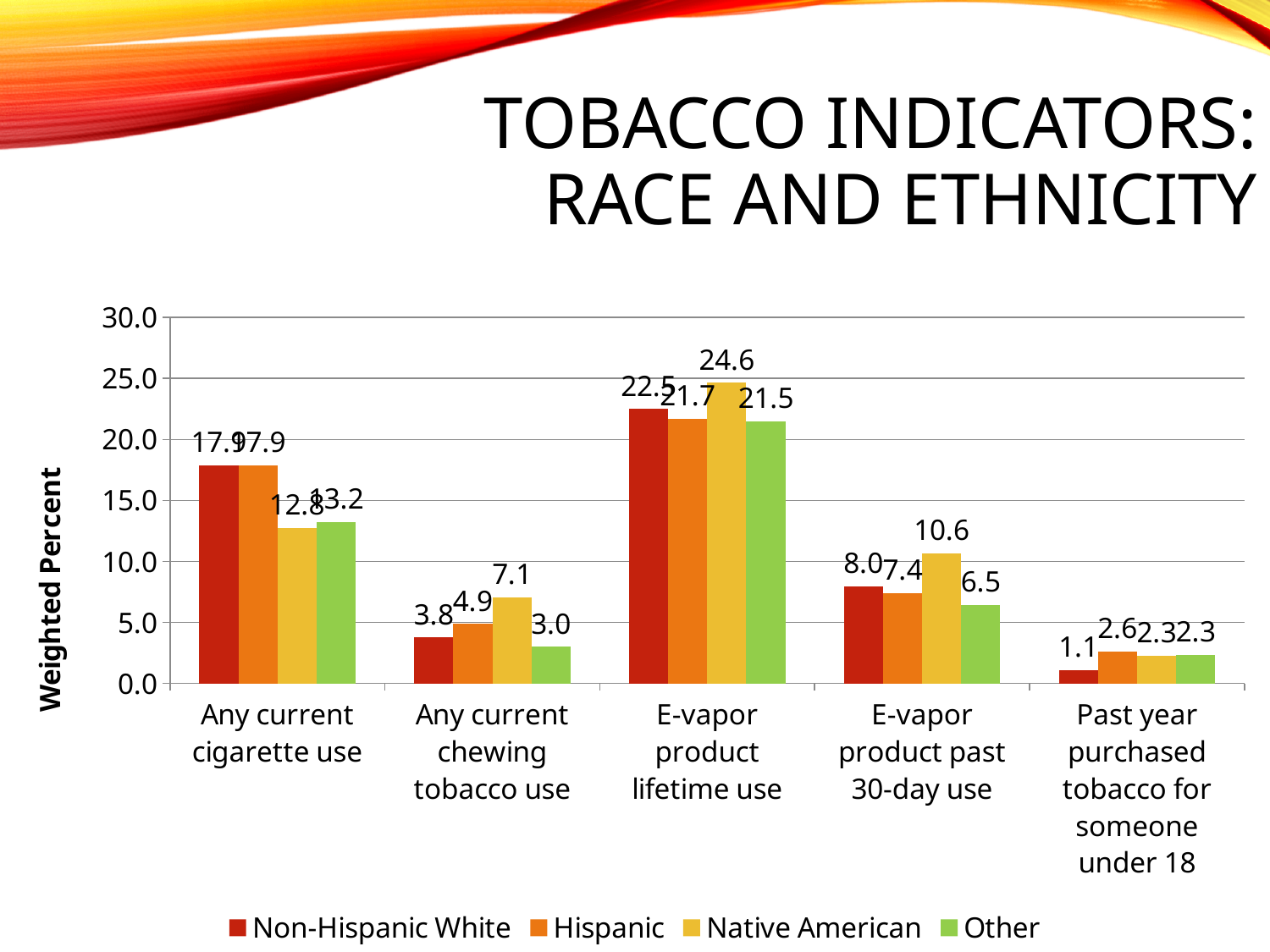
What is the value for Non-Hispanic White in the Past year purchased tobacco for someone under 18 category? 1.1 Which group has the highest value for E-vapor product lifetime use? Native American What is the difference between the Native American and Other values for E-vapor product past 30-day use? 4.1 How many tobacco indicator categories are shown on the x axis? 5 What kind of chart is shown on the slide? bar chart What is the value for Native American in the E-vapor product lifetime use category? 24.6 For Any current chewing tobacco use, which is larger: the Hispanic value or the Non-Hispanic White value? Hispanic Is the Native American value for Any current cigarette use greater or less than 15.0? less Which group has the lowest value for Any current chewing tobacco use? Other How many series does the legend list? 4 What is the title of the vertical axis? Weighted Percent What is the value for Other in the E-vapor product past 30-day use category? 6.5